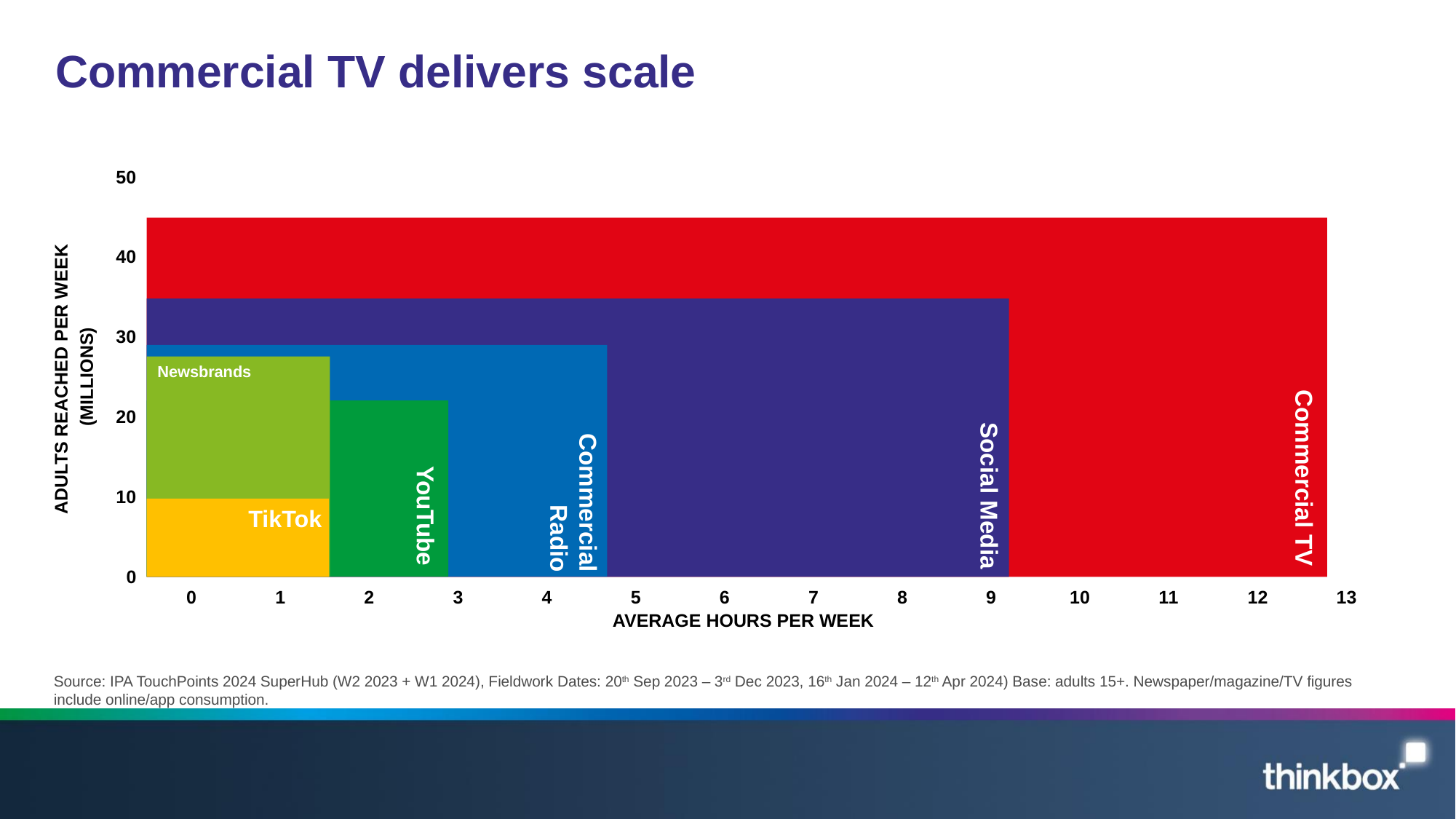
Which media category reaches the fewest adults per week? TikTok Is the average hours per week for Commercial Radio greater or less than 4? greater Is the number of adults reached per week by TikTok greater or less than 20 million? less How many media categories are labelled in the chart? 6 What kind of chart is shown on the slide? bar chart Which media category reaches the most adults per week? Commercial TV What is the title of the chart on the slide? Commercial TV delivers scale Is the number of adults reached per week by Social Media greater or less than 30 million? greater Which reaches more adults per week, Social Media or Commercial Radio? Social Media What is the label of the x axis of the chart? AVERAGE HOURS PER WEEK